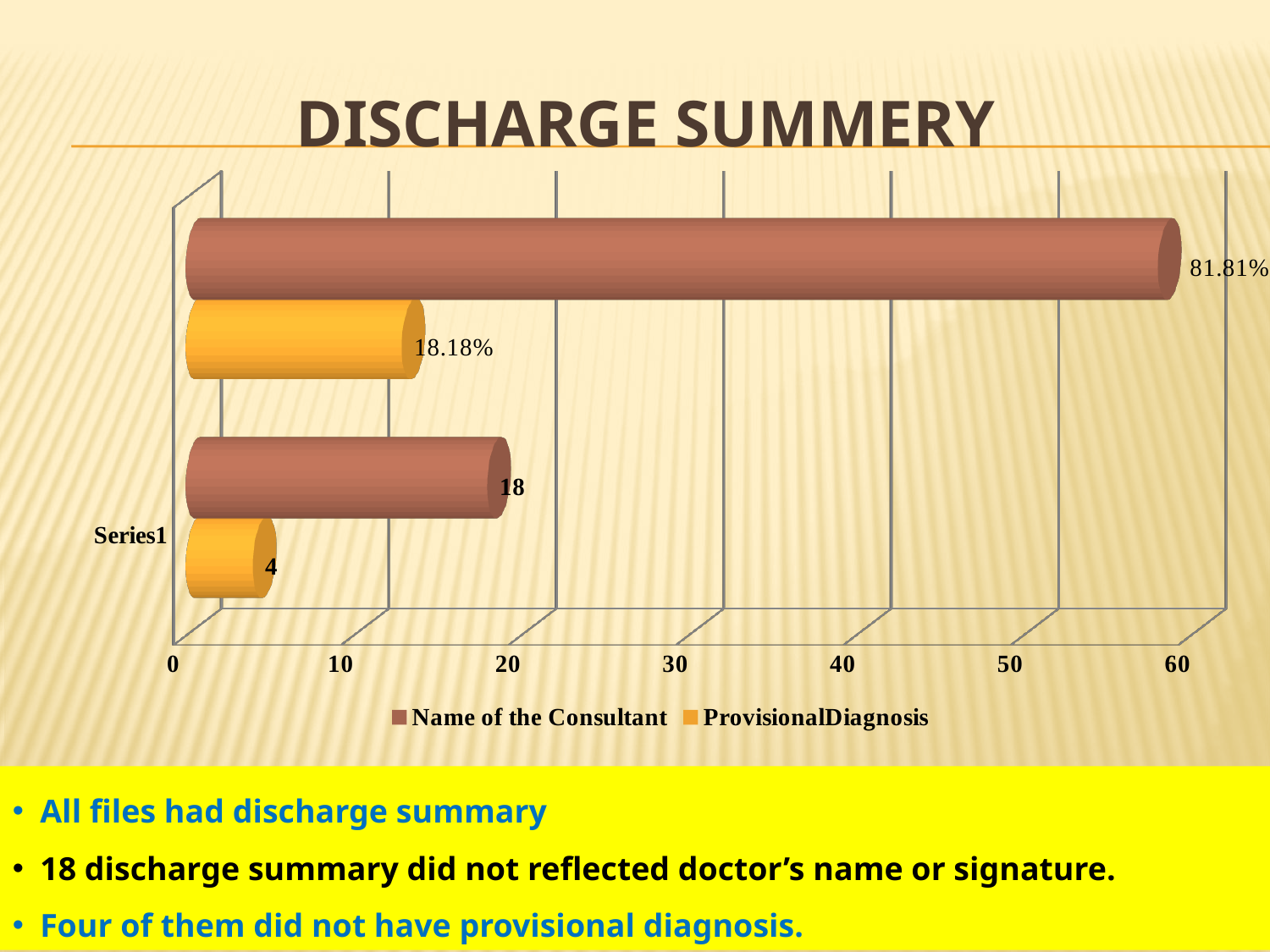
What is the value of the Name of the Consultant bar for Series1? 18 For Series1, what is the difference between the Name of the Consultant value and the ProvisionalDiagnosis value? 14 What is the value of the ProvisionalDiagnosis bar for Series1? 4 Is the value of the longest bar greater or less than 50 on the x axis? greater What data label is shown on the shortest bar in the chart? 4 For Series1, which series has the larger value, Name of the Consultant or ProvisionalDiagnosis? Name of the Consultant What is the title of the chart? DISCHARGE SUMMERY What data label is shown on the longest bar in the chart? 81.81% What kind of chart is shown on the slide? bar chart What are the two series named in the legend? Name of the Consultant and ProvisionalDiagnosis Is the ProvisionalDiagnosis bar for Series1 greater or less than 10 on the x axis? less How many series does the legend list? 2